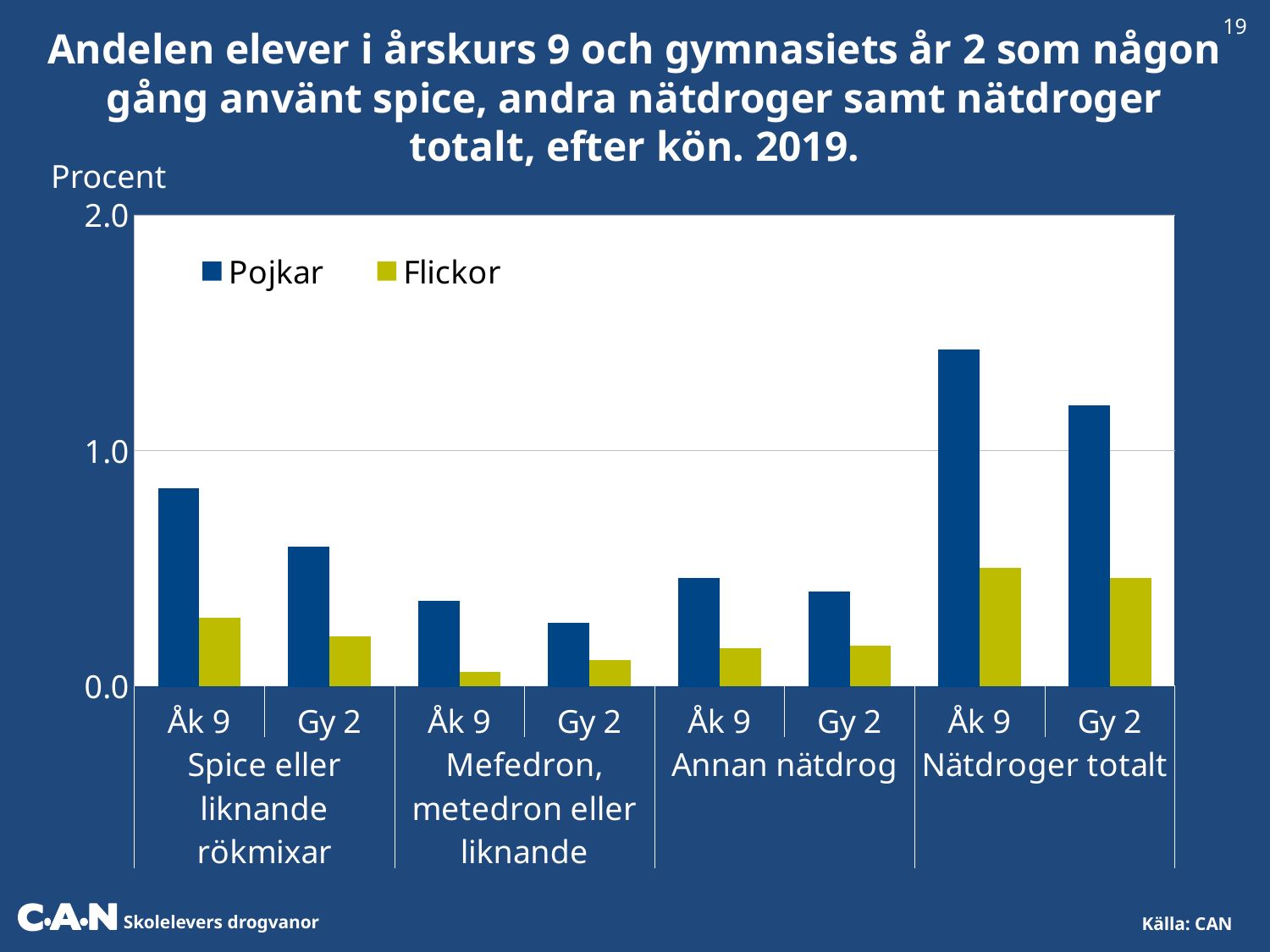
Is the Pojkar value for Åk 9 under Spice eller liknande rökmixar greater or less than 1.0? less Which category has the lowest Flickor value? Åk 9, Mefedron, metedron eller liknande How many category groups are shown along the x axis? 4 For Gy 2 under Spice eller liknande rökmixar, which is larger, Pojkar or Flickor? Pojkar Is the Pojkar value for Åk 9 under Nätdroger totalt greater or less than 1.0? greater What are the two series named in the legend? Pojkar and Flickor Is the Pojkar value for Gy 2 under Nätdroger totalt greater or less than 1.0? greater What unit is shown on the y axis label? Procent What kind of chart is shown on the slide? bar chart How many series does the legend list? 2 Which category has the highest Pojkar value? Åk 9, Nätdroger totalt